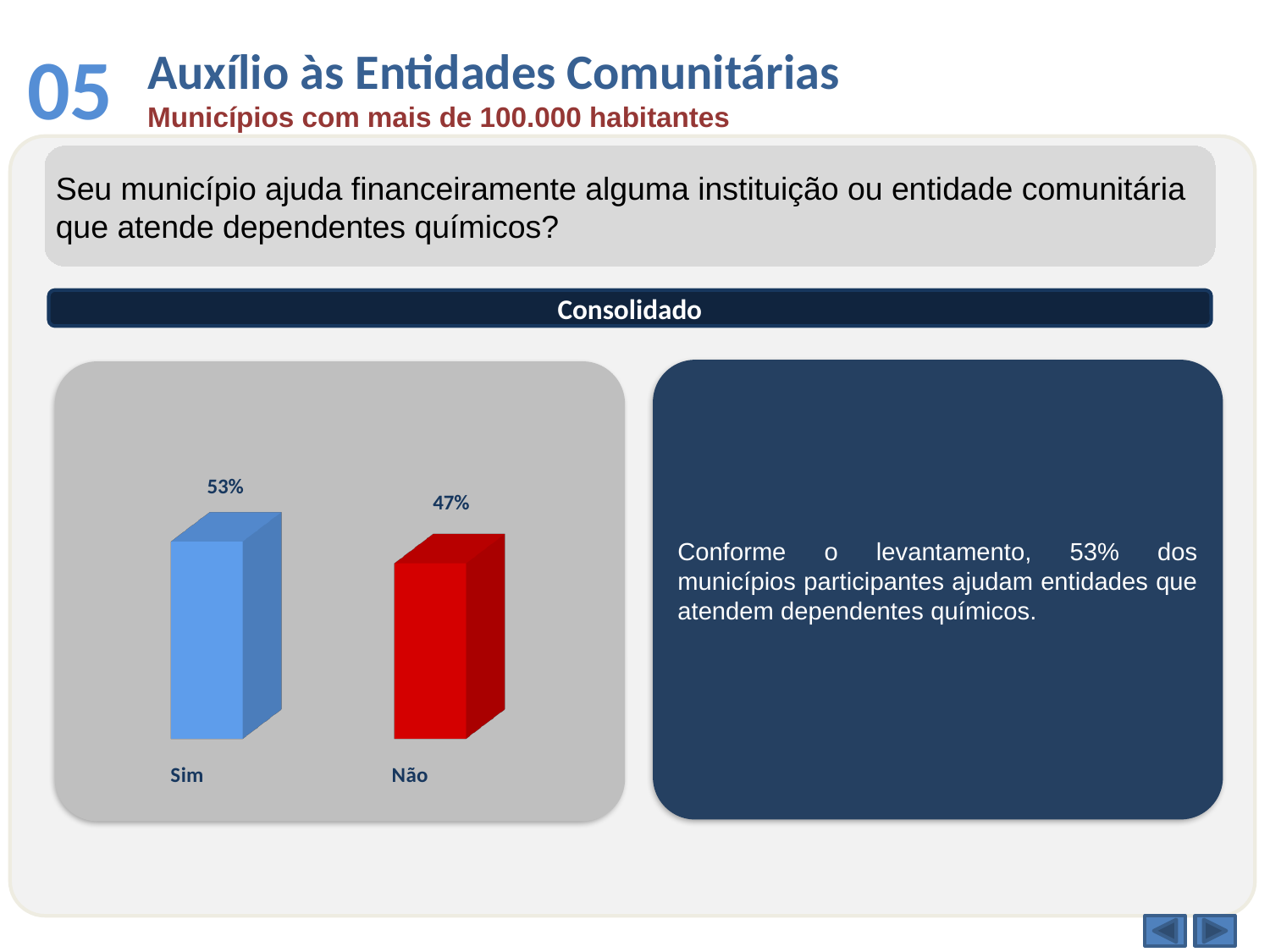
Which category has the lowest value? Não What colour is the bar for Não? Red What is the value for Sim? 53% What colour is the bar for Sim? Blue What is the difference between the values for Sim and Não? 6% What is the total of the two values shown in the chart? 100% Which category has the highest value? Sim Which is larger, the value for Sim or the value for Não? Sim What kind of chart is shown on the slide? Bar chart What is the value for Não? 47% How many categories are shown in the chart? 2